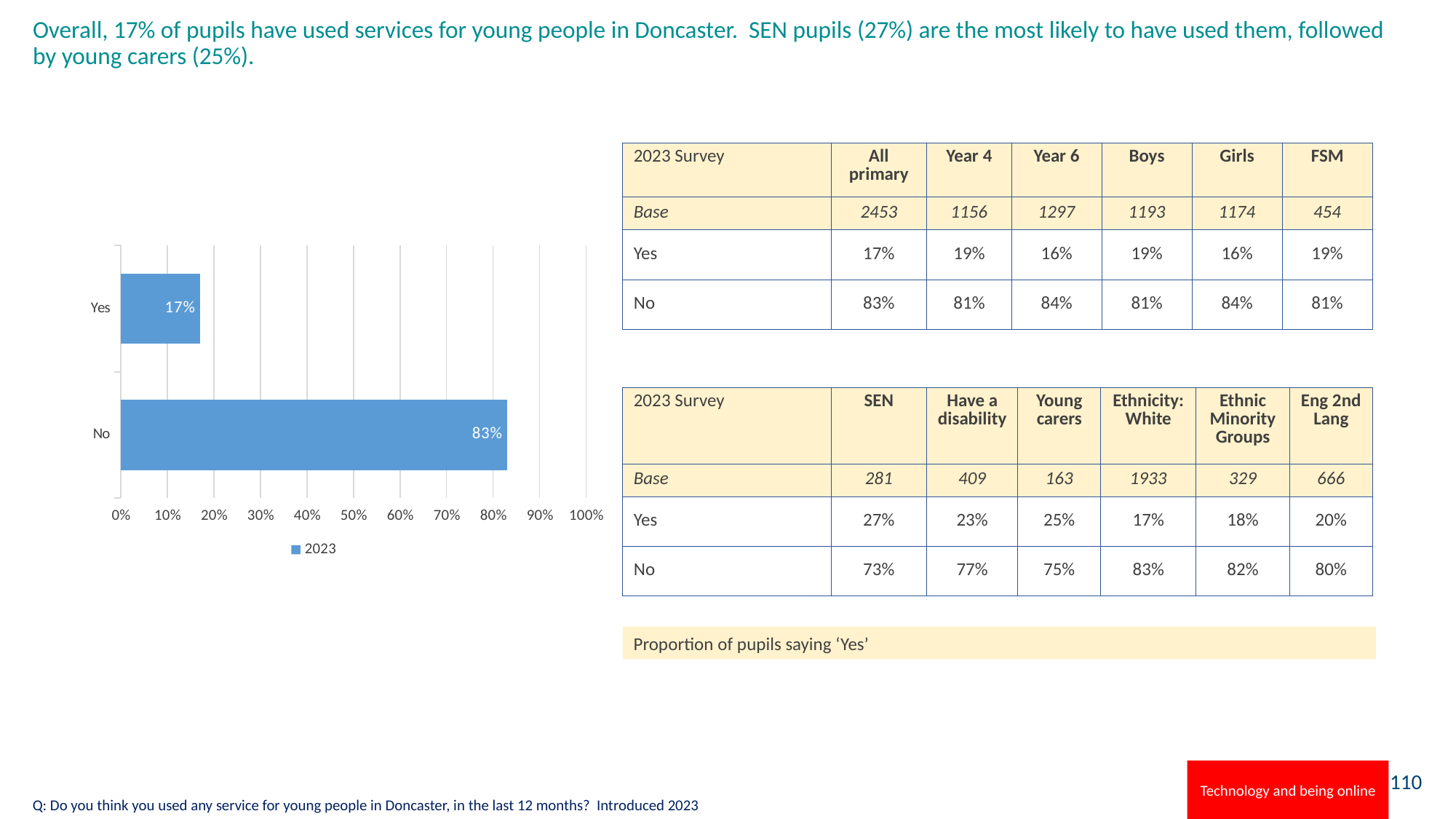
What is the value for 'Yes' in the bar chart? 17% How many categories are shown in the bar chart? 2 Which category has the lowest value in the bar chart? Yes Which category has the highest value in the bar chart? No What is the value for 'No' in the bar chart? 83% What kind of chart is shown on the slide? Bar chart Which is larger in the bar chart, the value for 'Yes' or the value for 'No'? No What is the difference between the 'No' and 'Yes' values in the bar chart? 66% What series name is shown in the legend of the bar chart? 2023 Is the value for 'Yes' in the bar chart greater or less than 20%? less How many series does the legend of the bar chart list? 1 Is the value for 'No' in the bar chart greater or less than 80%? greater